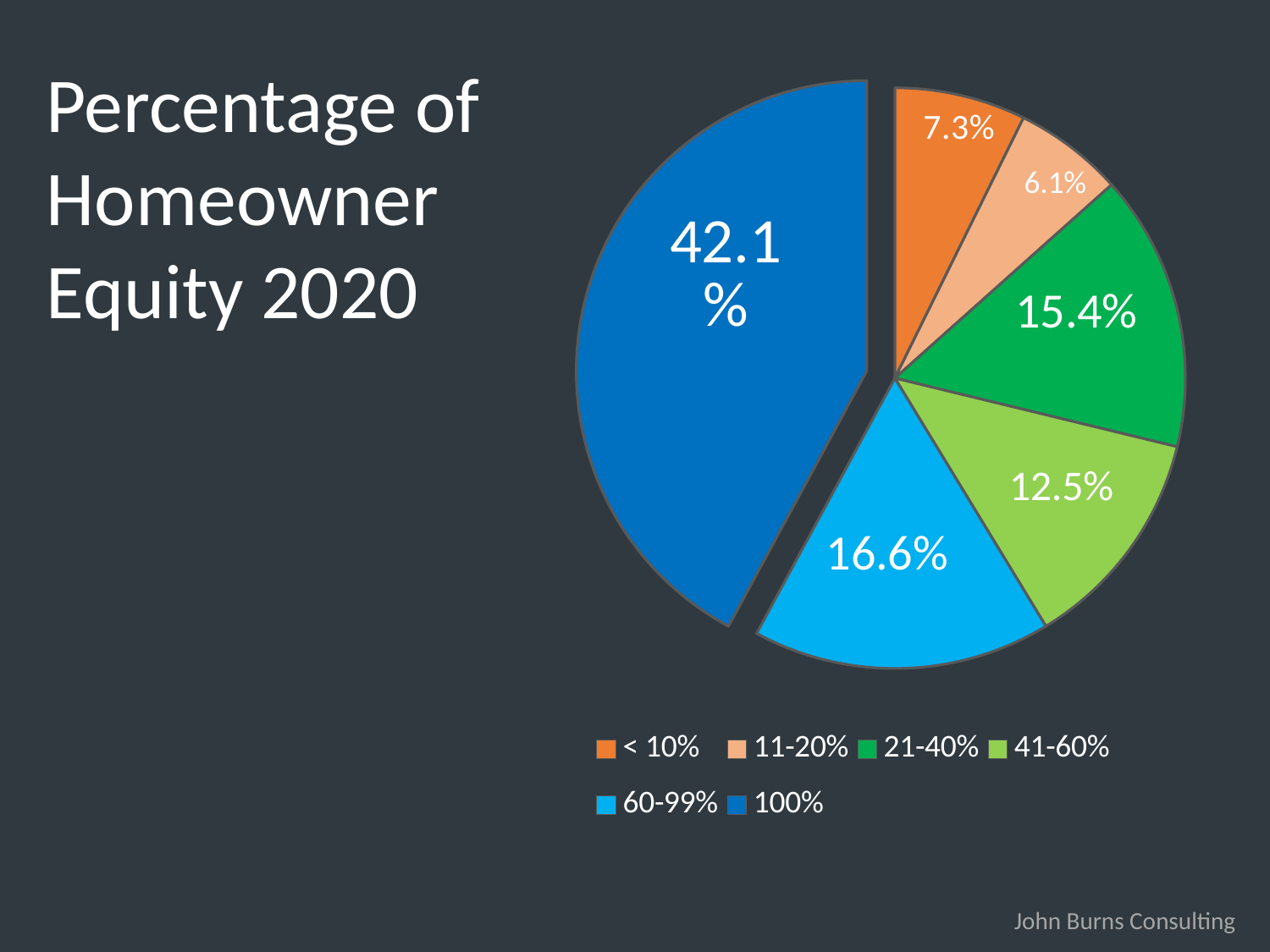
What is the value for the < 10% equity category? 7.3% Which equity category has the smallest share of the pie? 11-20% What is the value for the 60-99% equity category? 16.6% How many categories does the pie chart show? 6 What is the title of the chart? Percentage of Homeowner Equity 2020 What percentage of homeowners have 100% equity? 42.1% Which equity category has the largest share of the pie? 100% What is the difference between the 60-99% slice and the 41-60% slice? 4.1% What type of chart is shown on the slide? pie chart What colour is the 100% equity slice? dark blue What is the value for the 21-40% equity category? 15.4% Which is larger, the 21-40% slice or the 41-60% slice? 21-40%